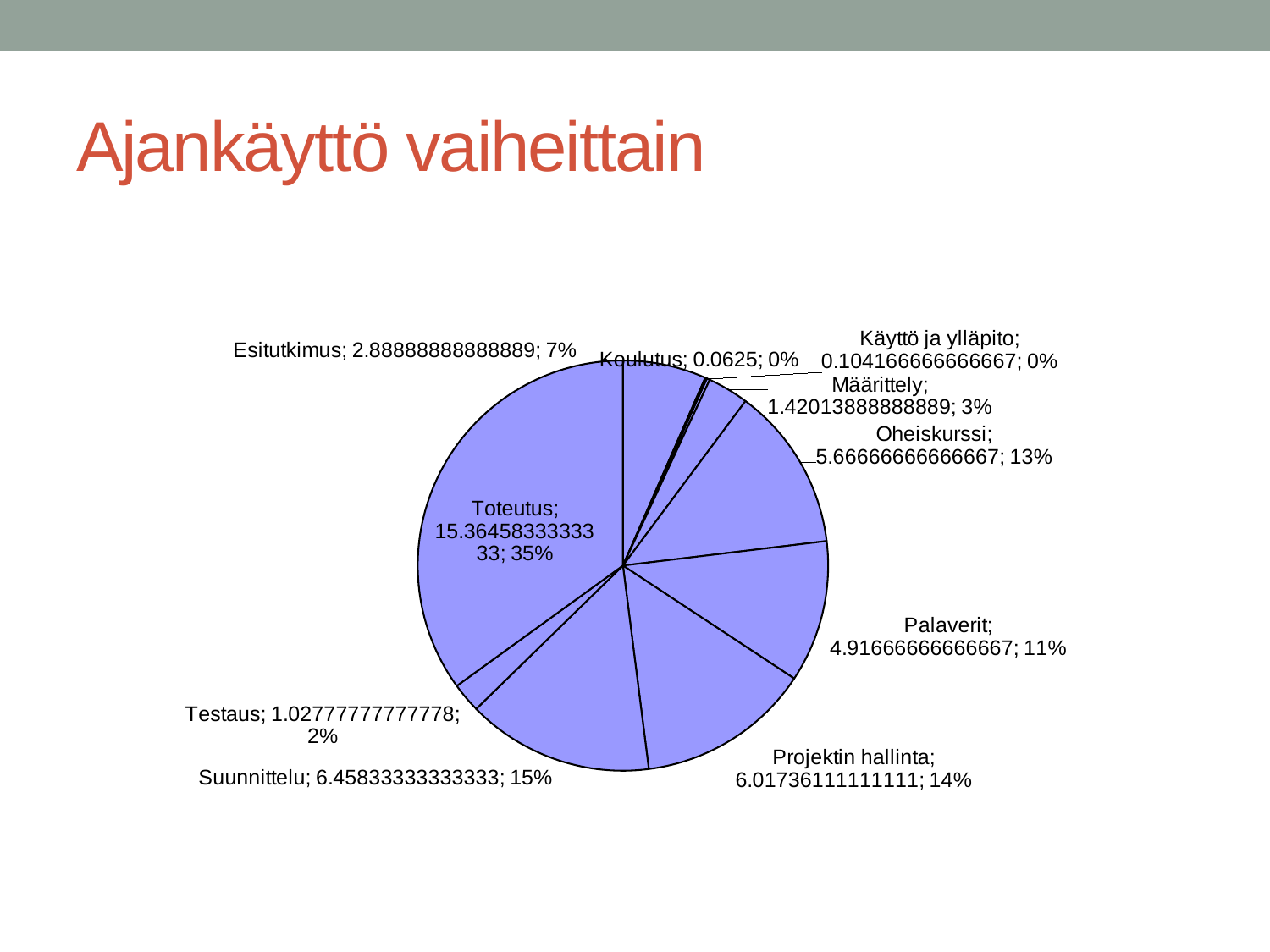
What share of the pie does Toteutus represent? 35% What is the difference in percentage points between the shares of Suunnittelu and Testaus? 13 Which category has the largest slice of the pie? Toteutus Which is larger, the slice for Projektin hallinta or the slice for Palaverit? Projektin hallinta What kind of chart is shown on the slide? pie chart What share of the pie does Suunnittelu represent? 15% How many slices does the pie chart have? 10 What is the title of the chart? Ajankäyttö vaiheittain Which category has the smallest slice of the pie? Koulutus What is the value shown for Palaverit? 4.91666666666667 What is the value shown for Koulutus? 0.0625 What share of the pie does Oheiskurssi represent? 13%